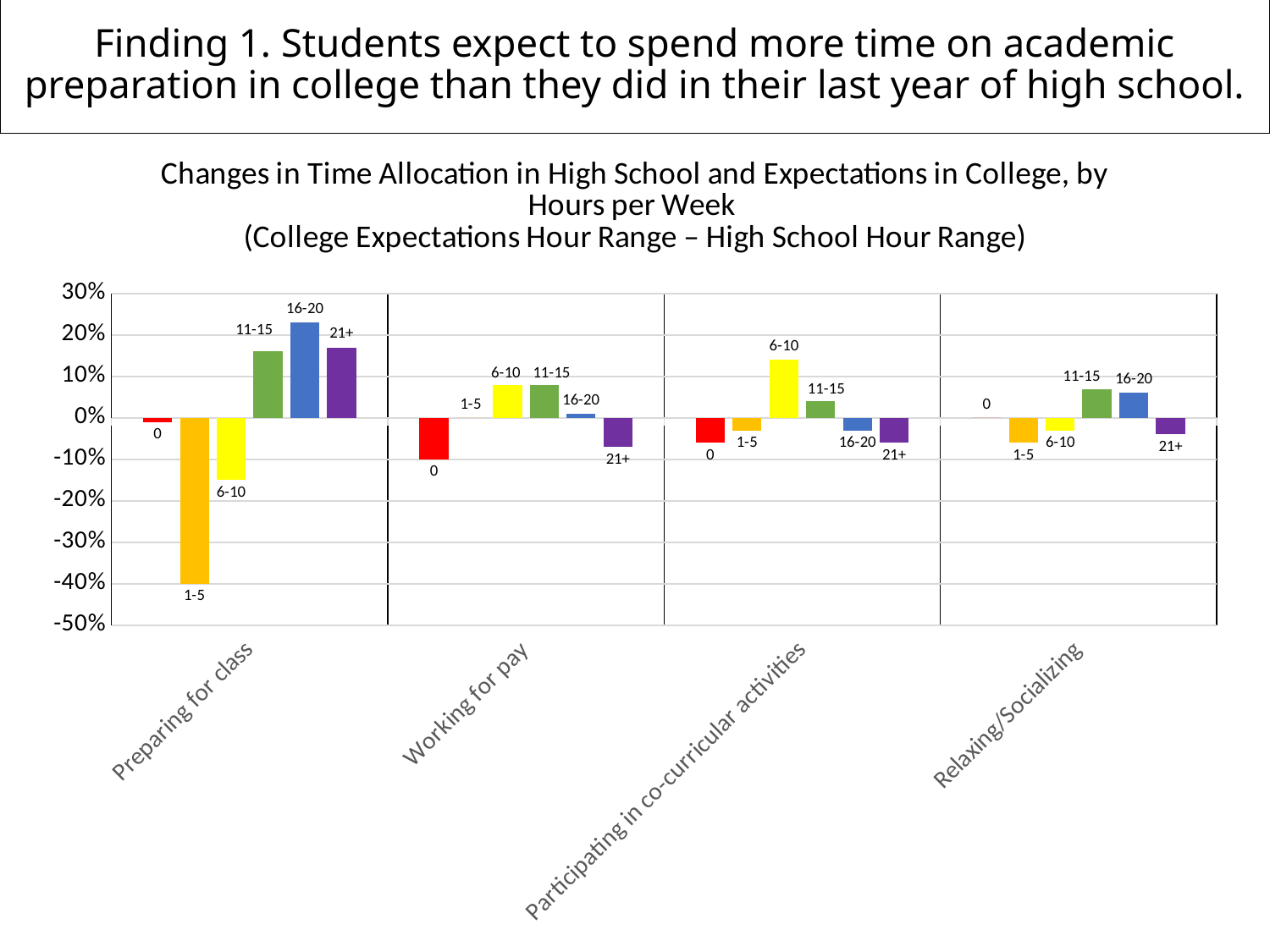
Is the value for the 6-10 bar in the Participating in co-curricular activities group greater or less than 10%? greater Which is larger: the 16-20 bar in the Preparing for class group or the 6-10 bar in the Participating in co-curricular activities group? 16-20 bar in Preparing for class Is the value for the 11-15 bar in the Relaxing/Socializing group greater or less than 10%? less Which hour-range bar is the highest in the Participating in co-curricular activities group? 6-10 Is the value for the 1-5 bar in the Preparing for class group greater or less than -30%? less How many activity categories are shown along the x axis? 4 Which hour-range bar is the highest in the Preparing for class group? 16-20 Which is larger: the 0 bar or the 21+ bar in the Working for pay group? 21+ What kind of chart is shown on the slide? bar chart Which hour-range bar is the lowest in the Preparing for class group? 1-5 What is the lowest value shown on the y axis? -50%